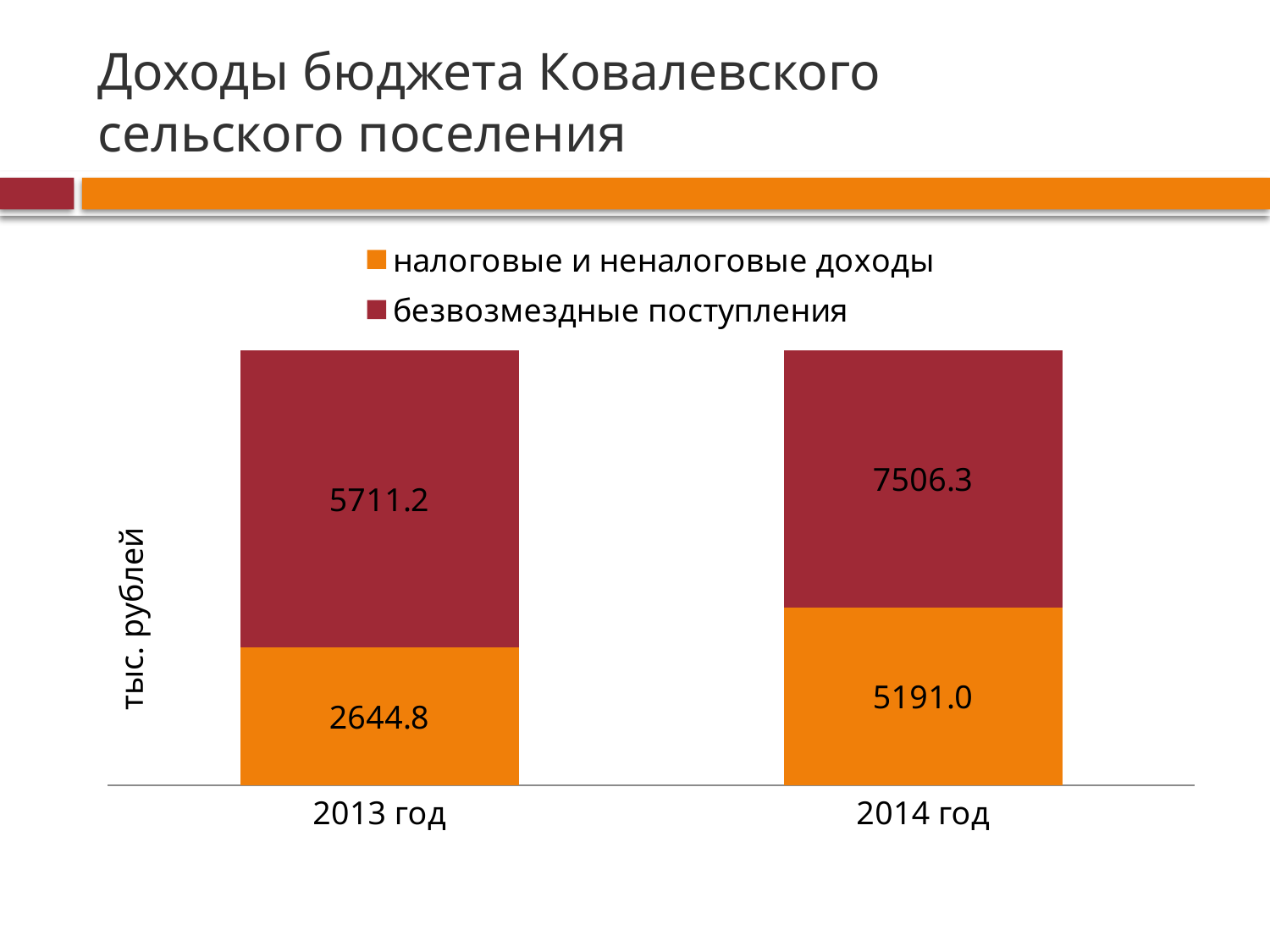
Which is larger in 2014 год: безвозмездные поступления or налоговые и неналоговые доходы? безвозмездные поступления What unit is shown on the vertical axis label? тыс. рублей What is the value for безвозмездные поступления in 2013 год? 5711.2 How many series does the legend list? 2 What is the value for налоговые и неналоговые доходы in 2013 год? 2644.8 What is the value for безвозмездные поступления in 2014 год? 7506.3 What is the difference between безвозмездные поступления and налоговые и неналоговые доходы in 2013 год? 3066.4 What is the value for налоговые и неналоговые доходы in 2014 год? 5191.0 What is the total of the stacked bar for 2013 год? 8356.0 By how much did налоговые и неналоговые доходы increase from 2013 год to 2014 год? 2546.2 What kind of chart is shown on the slide? stacked bar chart What is the total of the stacked bar for 2014 год? 12697.3